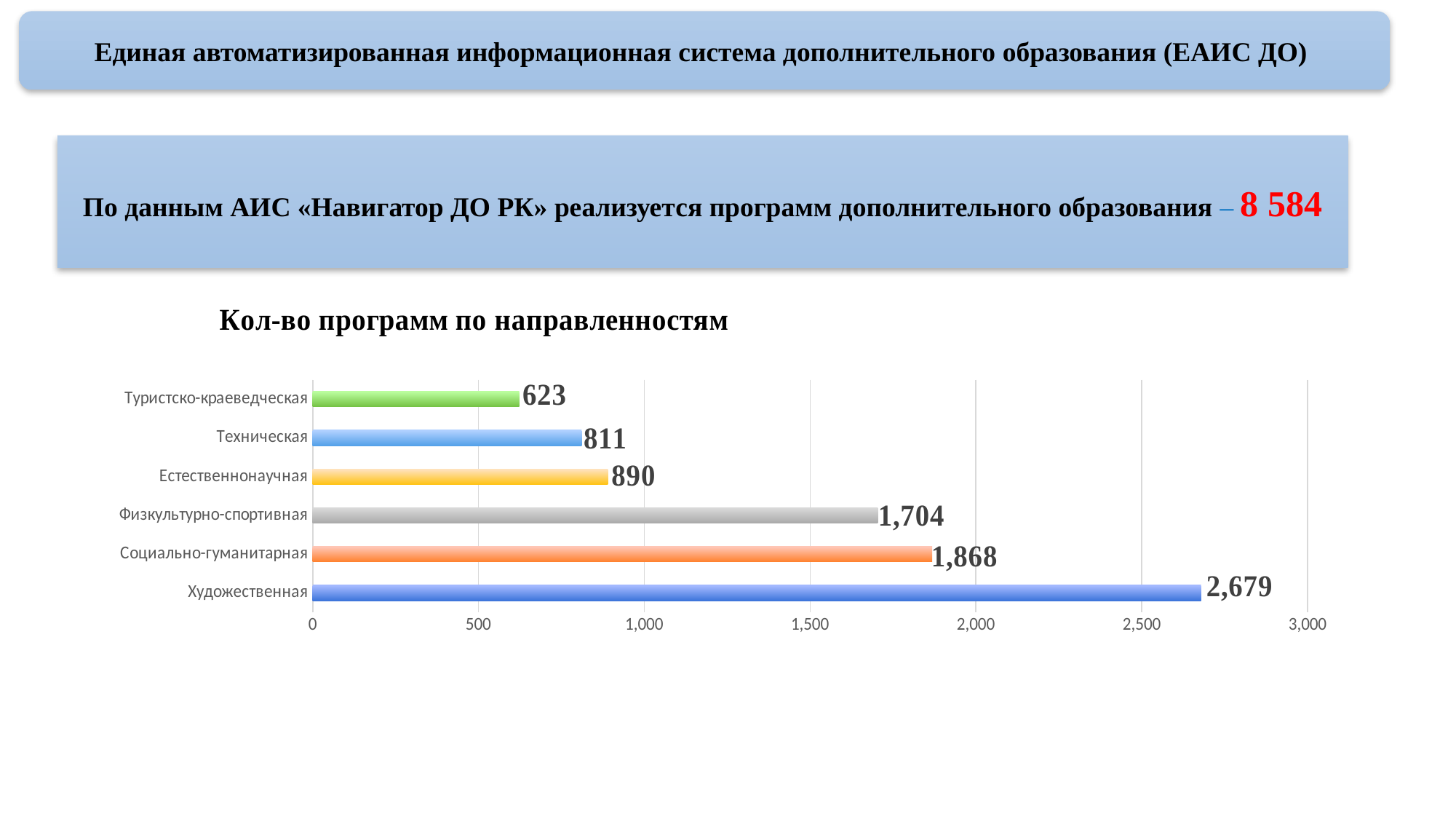
What is the value for Художественная? 2,679 Which category has the highest value? Художественная What kind of chart is shown on the slide? bar chart What is the title of the chart? Кол-во программ по направленностям What is the difference between the values for Художественная and Туристско-краеведческая? 2,056 What is the difference between the values for Социально-гуманитарная and Физкультурно-спортивная? 164 What is the value for Физкультурно-спортивная? 1,704 What is the value for Техническая? 811 Which category has the lowest value? Туристско-краеведческая How many categories are shown in the chart? 6 Is the value for Социально-гуманитарная greater or less than 1,500? greater Which is larger, the value for Естественнонаучная or the value for Техническая? Естественнонаучная